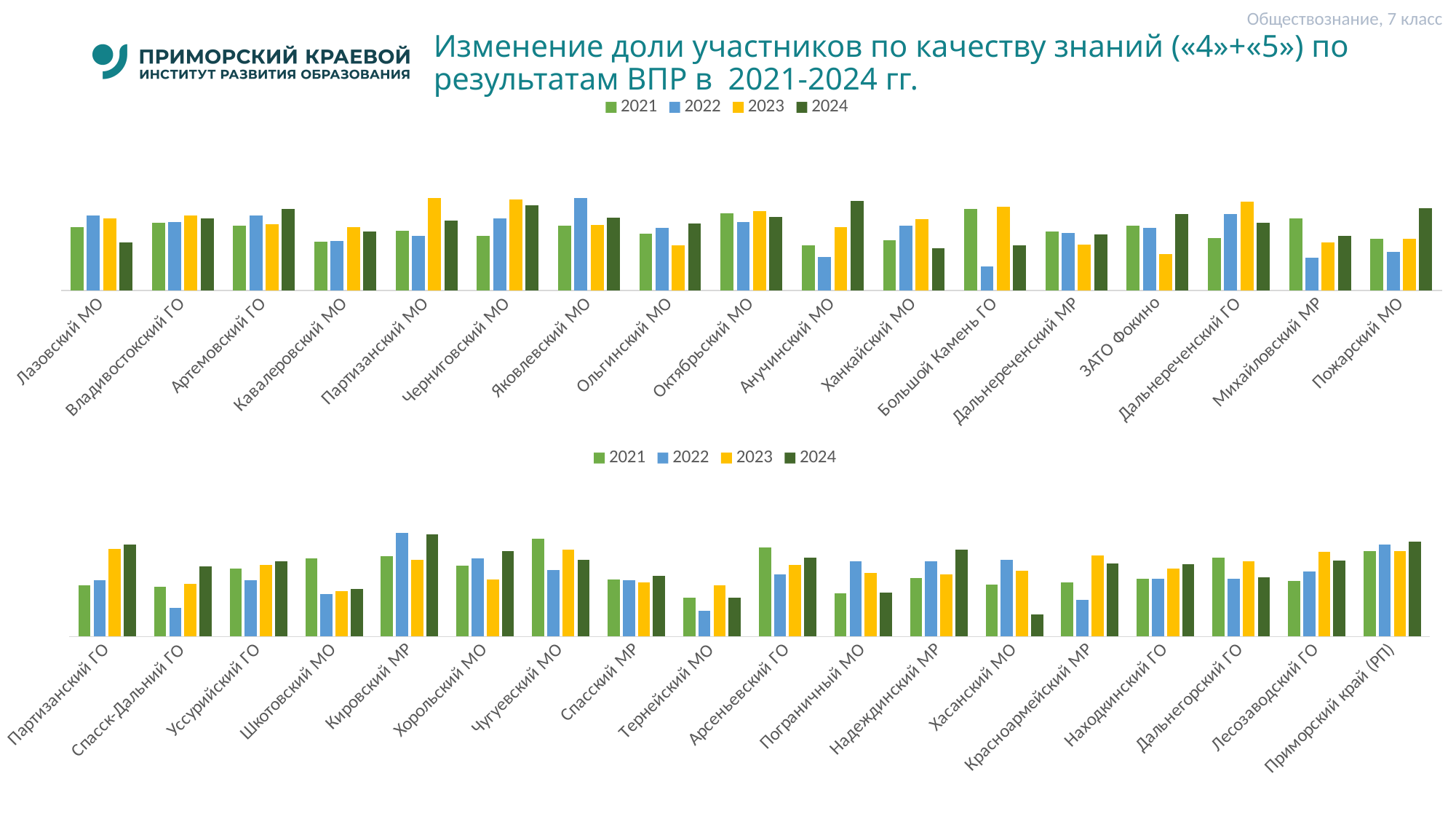
In the top chart, for Большой Камень ГО, which is larger: the 2022 bar or the 2023 bar? 2023 What kind of chart is the top chart on the slide? bar chart In the bottom chart, which year has the lowest bar for Хасанский МО? 2024 How many series does the legend of the top chart list? 4 In the top chart, which year has the highest bar for Яковлевский МО? 2022 How many categories are shown on the x axis of the top chart? 17 Which years are listed in the legend of the bottom chart? 2021, 2022, 2023, 2024 How many categories are shown on the x axis of the bottom chart? 18 In the bottom chart, for Кировский МР, which is larger: the 2022 bar or the 2023 bar? 2022 In the bottom chart, do the bars for Партизанский ГО rise or fall from 2021 to 2024? rise In the bottom chart, which year has the lowest bar for Спасск-Дальний ГО? 2022 In the top chart, which year has the highest bar for Анучинский МО? 2024